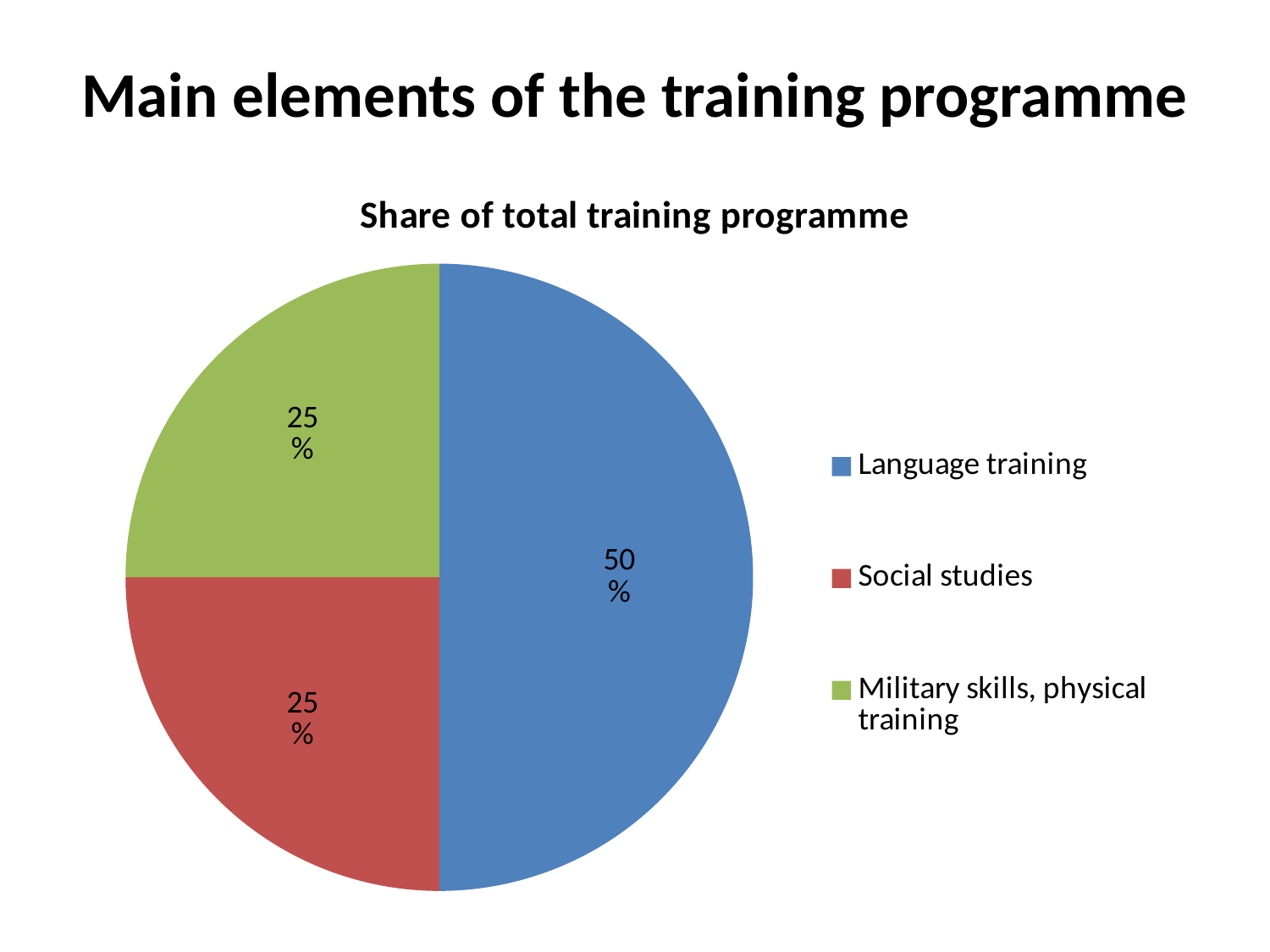
What is the combined share of Social studies and Military skills, physical training? 50% How many categories does the pie chart show? 3 What share of the total training programme is Military skills, physical training? 25% How many entries does the legend list? 3 What is the difference between the share for Language training and the share for Social studies? 25% Which element has the largest share of the training programme? Language training What share of the total training programme is Social studies? 25% What kind of chart is shown on the slide? pie chart What is the title of the chart? Share of total training programme Which colour represents Social studies in the pie chart? red Which is larger, the share for Language training or the share for Military skills, physical training? Language training What share of the total training programme is Language training? 50%